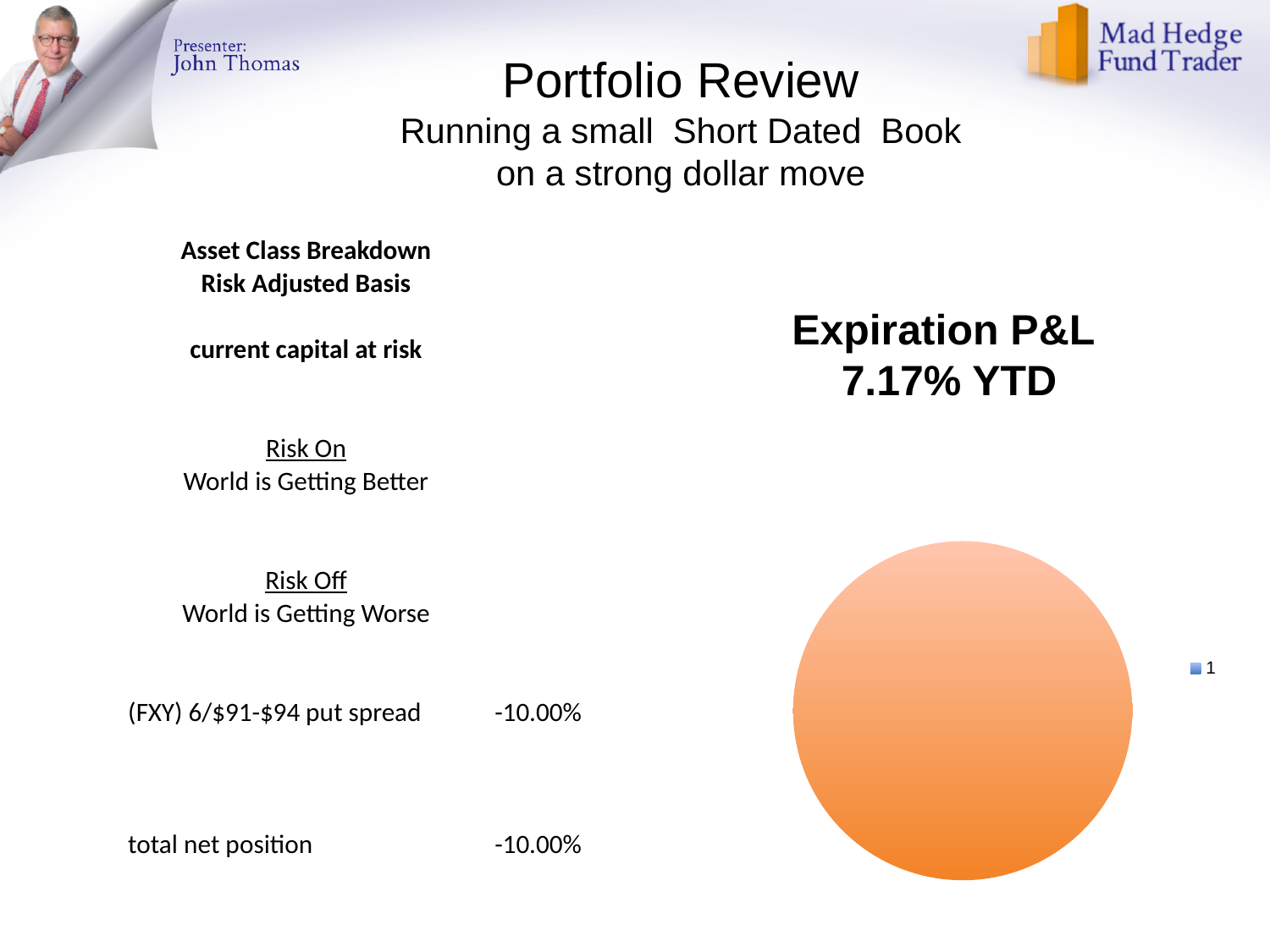
What label does the legend of the pie chart show? 1 What kind of chart is shown on the slide? pie chart How many entries does the legend of the pie chart list? 1 What colour is the slice of the pie chart? orange How many slices does the pie chart have? 1 What share of the pie chart does the single slice occupy? 100%